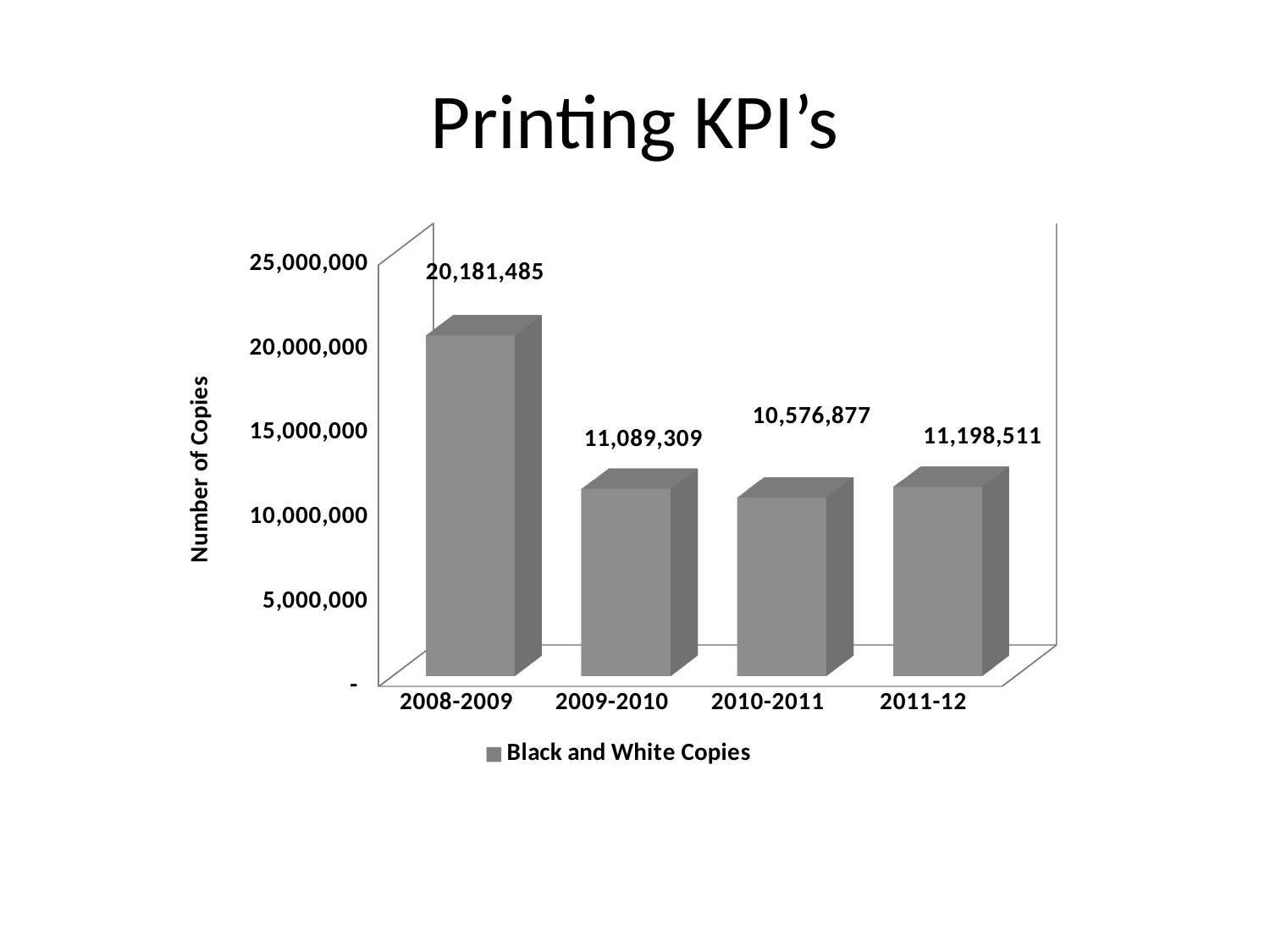
What is the number of Black and White Copies for 2008-2009? 20,181,485 What is the difference in Black and White Copies between 2011-12 and 2010-2011? 621,634 Which year has more Black and White Copies, 2008-2009 or 2010-2011? 2008-2009 Which year has the highest number of Black and White Copies? 2008-2009 What is the difference in Black and White Copies between 2008-2009 and 2009-2010? 9,092,176 What is the number of Black and White Copies for 2010-2011? 10,576,877 Is the value for 2008-2009 greater or less than 15,000,000? greater How many years are shown on the x axis of the chart? 4 Which year has the lowest number of Black and White Copies? 2010-2011 What type of chart is shown on the slide? Bar chart What is the number of Black and White Copies for 2011-12? 11,198,511 What is the number of Black and White Copies for 2009-2010? 11,089,309